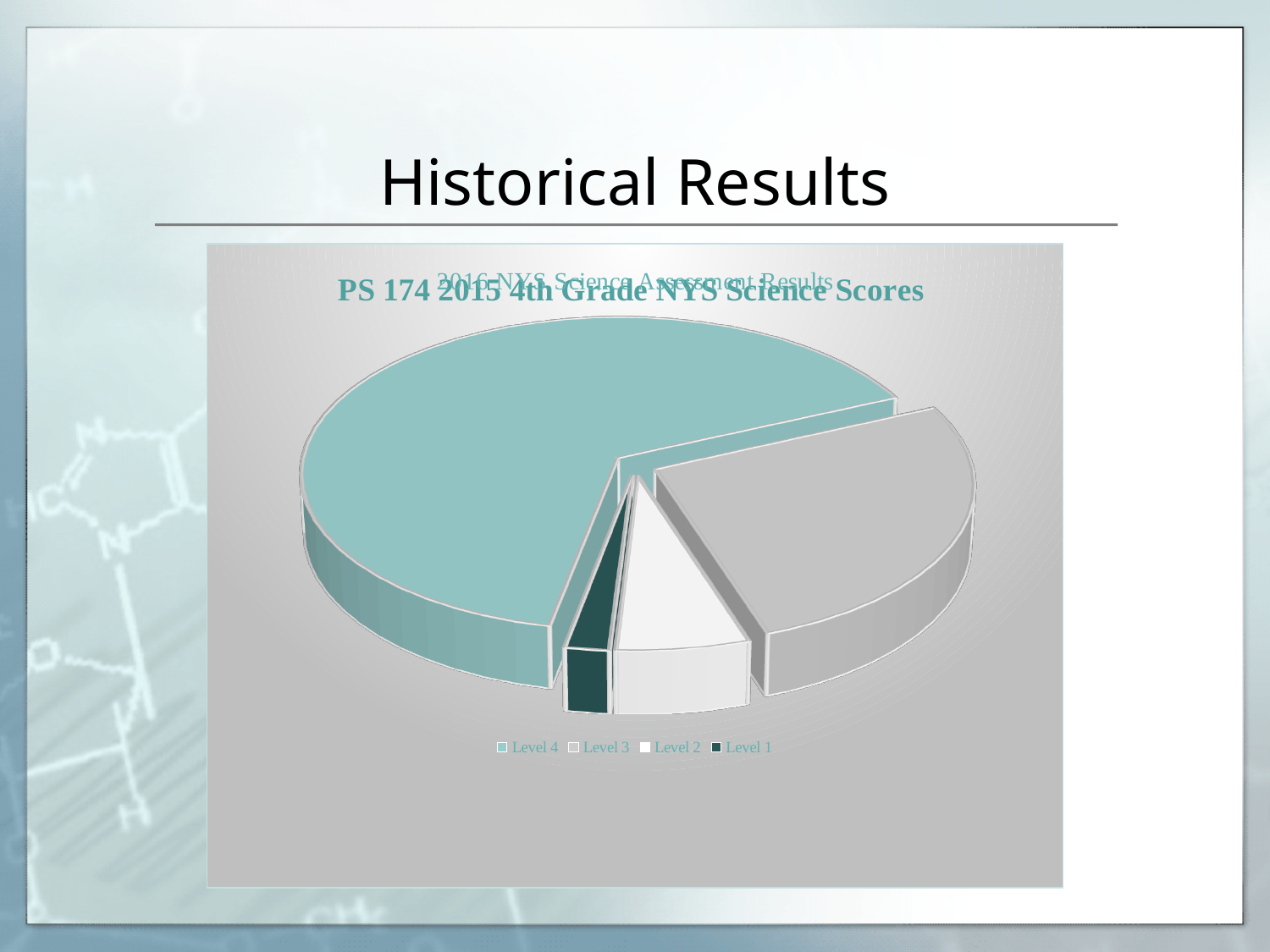
Which slice is larger, Level 3 or Level 2? Level 3 What is the bold title of the pie chart? PS 174 2015 4th Grade NYS Science Scores What kind of chart is shown on the slide? Pie chart Which slice is larger, Level 4 or Level 2? Level 4 How many slices does the pie chart have? 4 Which slice is larger, Level 2 or Level 1? Level 2 How many entries does the legend of the pie chart list? 4 Which level has the largest slice of the pie chart? Level 4 Which level has the smallest slice of the pie chart? Level 1 Which legend entry is shown in dark green in the pie chart? Level 1